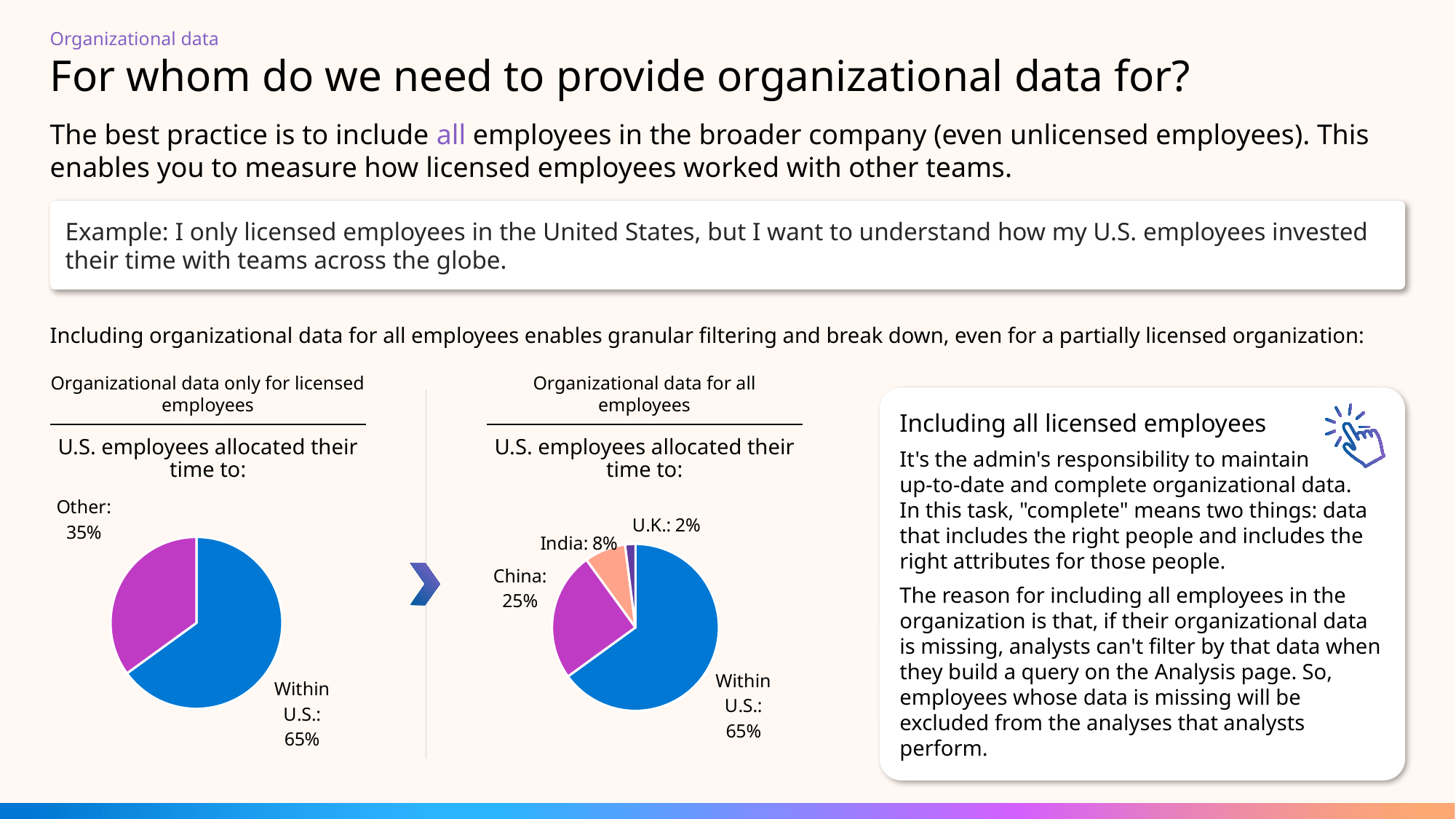
In the right pie chart (Organizational data for all employees), which is larger, the share for China or the share for India? China In the right pie chart (Organizational data for all employees), which category has the smallest slice? U.K. In the left pie chart (Organizational data only for licensed employees), what share of time did U.S. employees allocate Within U.S.? 65% In the right pie chart (Organizational data for all employees), what share of time did U.S. employees allocate to India? 8% In the right pie chart (Organizational data for all employees), what share of time did U.S. employees allocate to the U.K.? 2% In the right pie chart (Organizational data for all employees), what share of time did U.S. employees allocate to China? 25% What type of chart is used on the left side of the slide (Organizational data only for licensed employees)? Pie chart In the right pie chart (Organizational data for all employees), how many slices are there? 4 In the right pie chart (Organizational data for all employees), what is the difference between the China and India shares? 17% In the left pie chart (Organizational data only for licensed employees), how many slices are there? 2 In the right pie chart (Organizational data for all employees), which category has the largest slice? Within U.S. In the left pie chart (Organizational data only for licensed employees), what share of time did U.S. employees allocate to Other? 35%